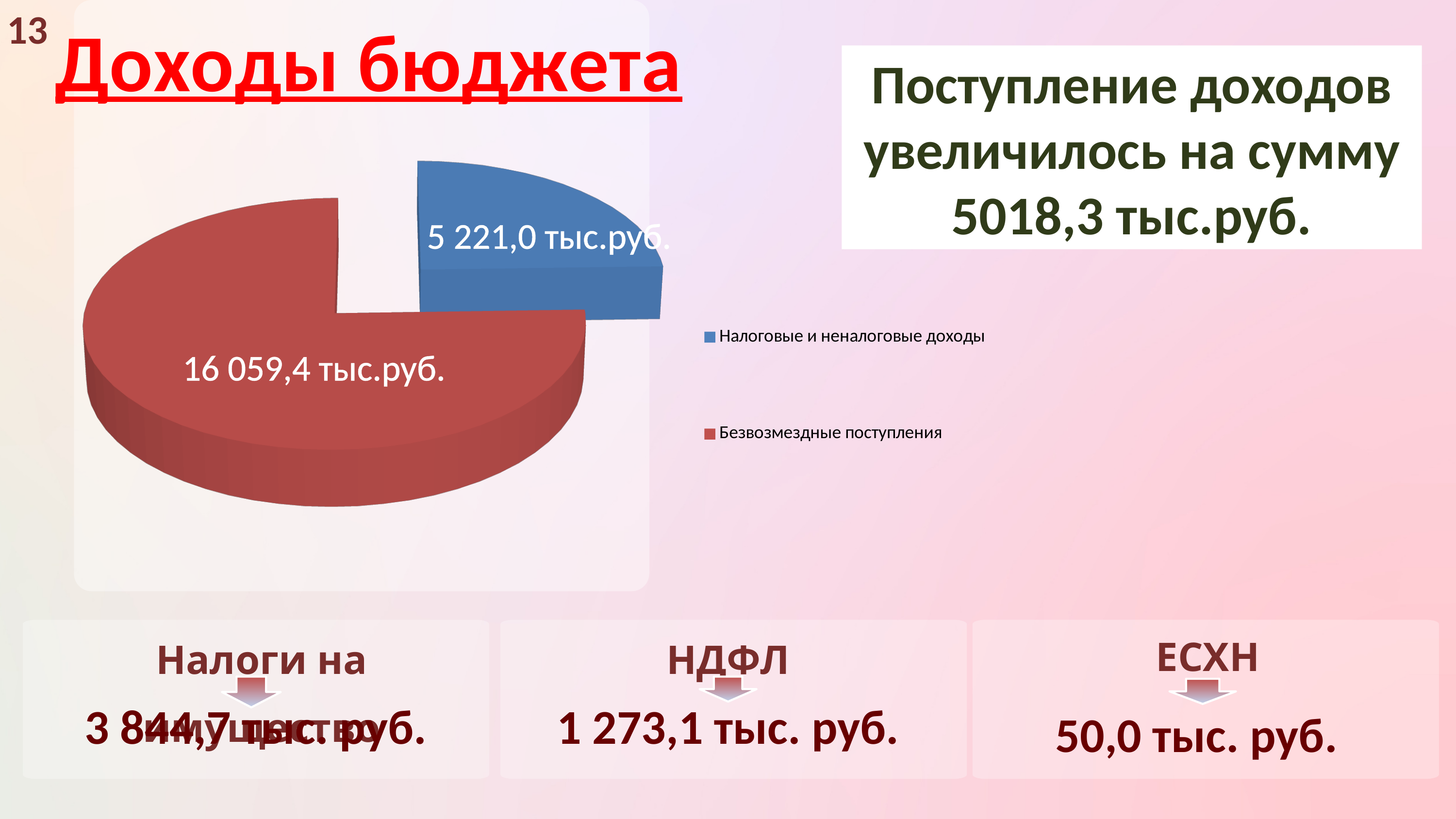
Which category has the largest slice in the pie chart? Безвозмездные поступления Which category has the smallest slice in the pie chart? Налоговые и неналоговые доходы What is the total of the two slices in the pie chart? 21 280,4 тыс.руб. What value is shown for Налоговые и неналоговые доходы in the pie chart? 5 221,0 тыс.руб. How many slices does the pie chart have? 2 Which colour represents Безвозмездные поступления in the pie chart? Red What type of chart is shown on the slide? Pie chart What share of the pie does Безвозмездные поступления represent? 75.5% Which is larger in the pie chart: Налоговые и неналоговые доходы or Безвозмездные поступления? Безвозмездные поступления What is the difference between Безвозмездные поступления and Налоговые и неналоговые доходы in the pie chart? 10 838,4 тыс.руб. What value is shown for Безвозмездные поступления in the pie chart? 16 059,4 тыс.руб. What share of the pie does Налоговые и неналоговые доходы represent? 24.5%